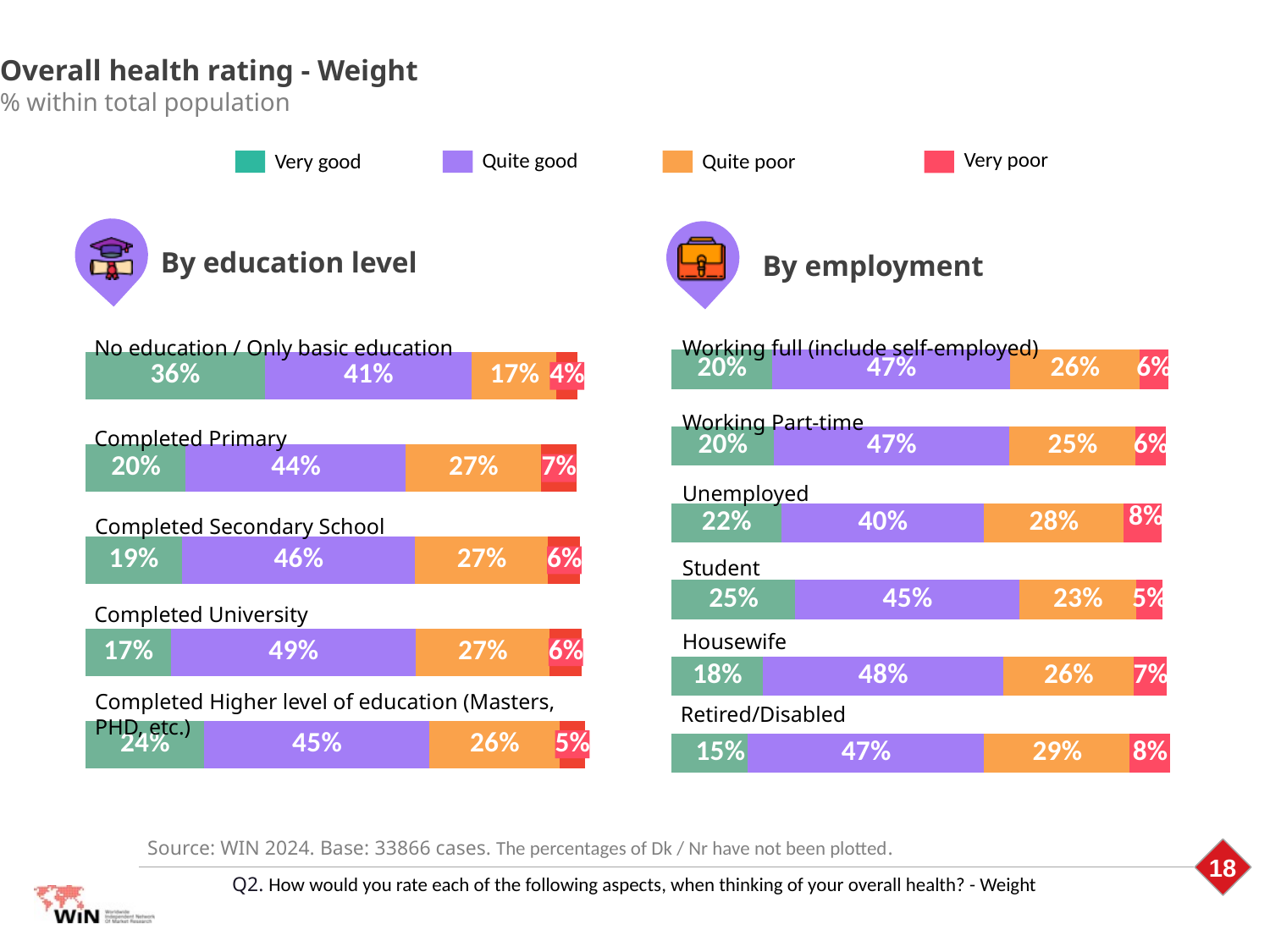
What kind of chart is used on this slide? Stacked bar chart In the By education level chart, what is the Quite good value for Completed University? 49% How many series does the legend list? 4 In the By employment chart, what is the difference between the Quite poor values for Unemployed and Student? 5 percentage points How many employment groups are shown in the By employment chart? 6 In the By education level chart, which education level has the highest Very good value? No education / Only basic education In the By education level chart, what is the Very good value for No education / Only basic education? 36% In the By employment chart, what is the Very poor value for Retired/Disabled? 8% In the By education level chart, what is the total of the plotted values for the No education / Only basic education bar? 98% In the By employment chart, which employment group has the lowest Very good value? Retired/Disabled In the By employment chart, which has the larger Quite good value, Housewife or Unemployed? Housewife How many education levels are shown in the By education level chart? 5